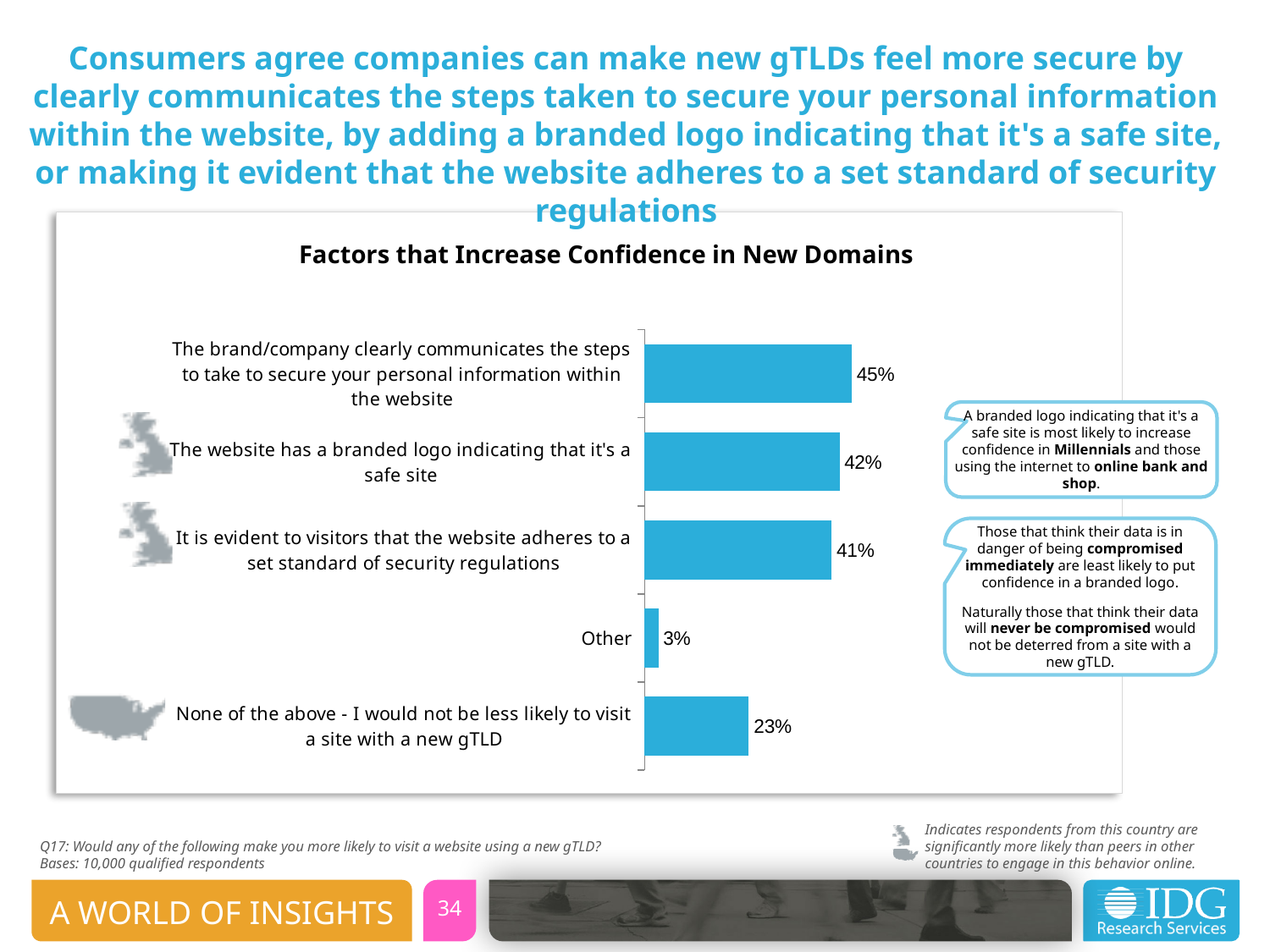
What is the value for 'Other'? 3% What percentage selected 'None of the above - I would not be less likely to visit a site with a new gTLD'? 23% What is the difference between the percentage for the branded logo factor and the 'None of the above' option? 19% What is the value for 'The website has a branded logo indicating that it's a safe site'? 42% What percentage of respondents said the brand/company clearly communicating the steps to secure personal information would increase their confidence? 45% What type of chart is used on this slide? Bar chart How many categories are shown in the chart? 5 Which is larger: the value for the branded logo factor or the value for the security regulations factor? The website has a branded logo indicating that it's a safe site What is the title of the chart? Factors that Increase Confidence in New Domains Which factor has the highest percentage in the chart? The brand/company clearly communicates the steps to take to secure your personal information within the website What percentage chose 'It is evident to visitors that the website adheres to a set standard of security regulations'? 41% Which category has the lowest percentage in the chart? Other